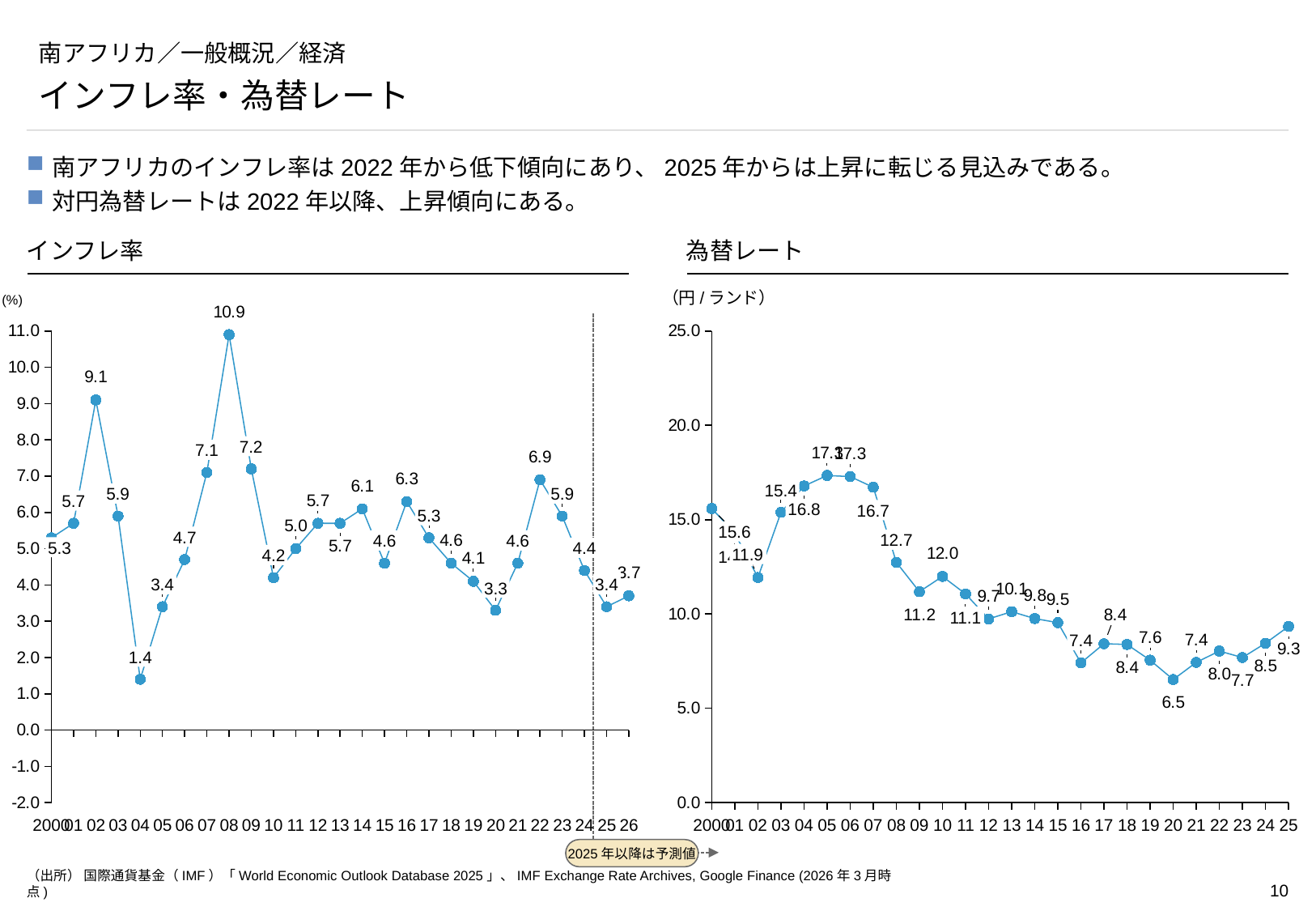
In the 為替レート chart, which year has the lowest exchange rate? 2020 In the インフレ率 chart, how many years (data points) are plotted? 27 In the 為替レート chart, which is larger, the value for 2003 or the value for 2008? 2003 What unit is shown on the 為替レート chart's axis label? 円/ランド What kind of chart is the インフレ率 chart? line chart In the インフレ率 chart, what is the difference between the 2008 value and the 2004 value? 9.5 In the 為替レート chart, is the value for 2001 greater or less than 15.0? less In the インフレ率 chart, which year has the lowest inflation rate? 2004 In the インフレ率 chart, which year has the highest inflation rate? 2008 In the 為替レート chart, what is the value for 2020? 6.5 In the 為替レート chart, do the values rise or fall from 2020 to 2025? rise In the インフレ率 chart, what is the inflation rate for 2022? 6.9